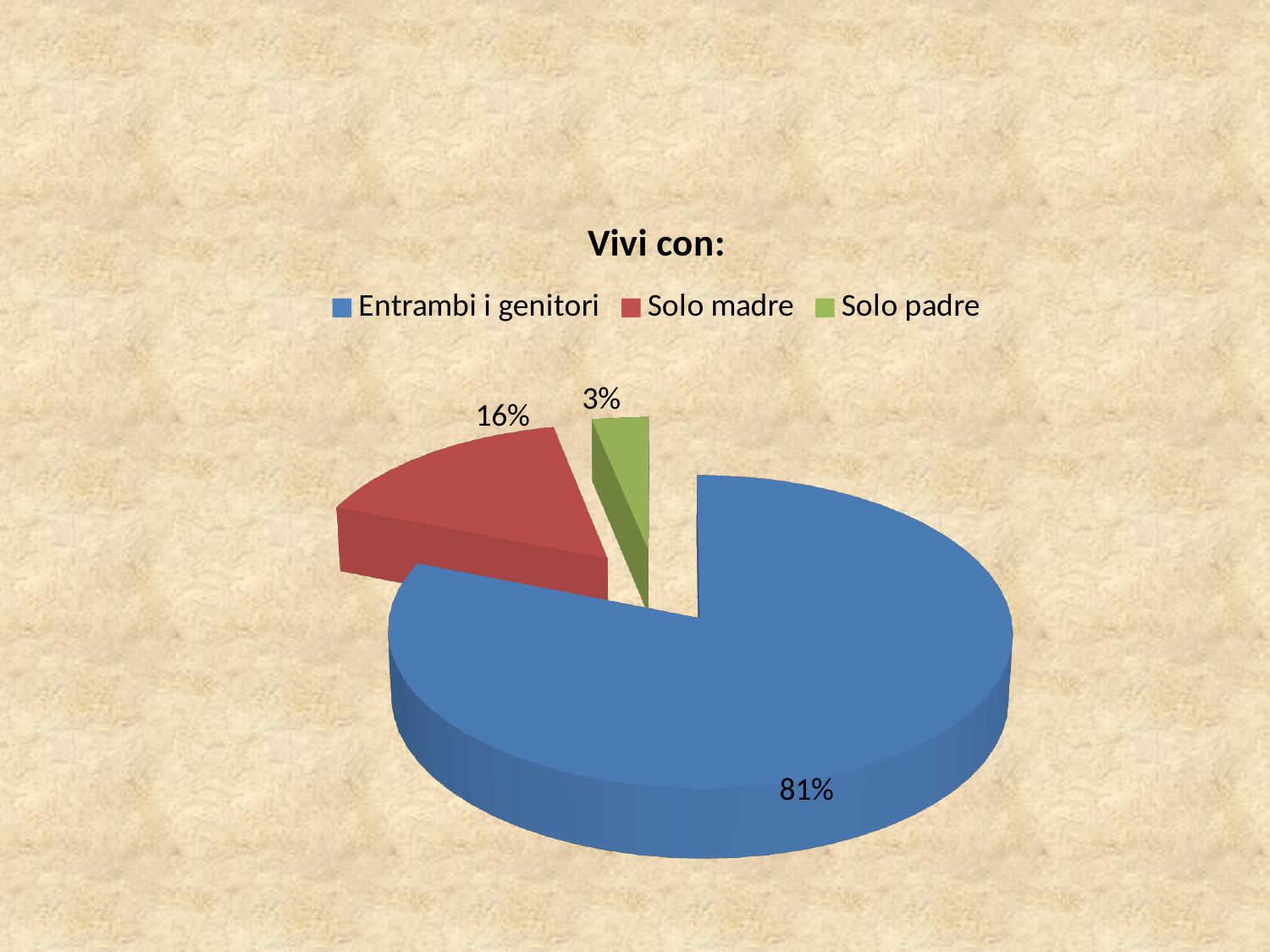
How many entries does the legend list? 3 What share of the pie is 'Solo madre'? 16% What colour is the 'Solo madre' slice? red What share of the pie is 'Entrambi i genitori'? 81% How many slices does the pie chart have? 3 Which is larger, the 'Solo madre' slice or the 'Solo padre' slice? Solo madre Which category has the smallest slice of the pie? Solo padre What is the difference between the 'Solo madre' and 'Solo padre' shares? 13% What is the title of the chart? Vivi con: What kind of chart is shown on the slide? pie chart Which category has the largest slice of the pie? Entrambi i genitori What share of the pie is 'Solo padre'? 3%